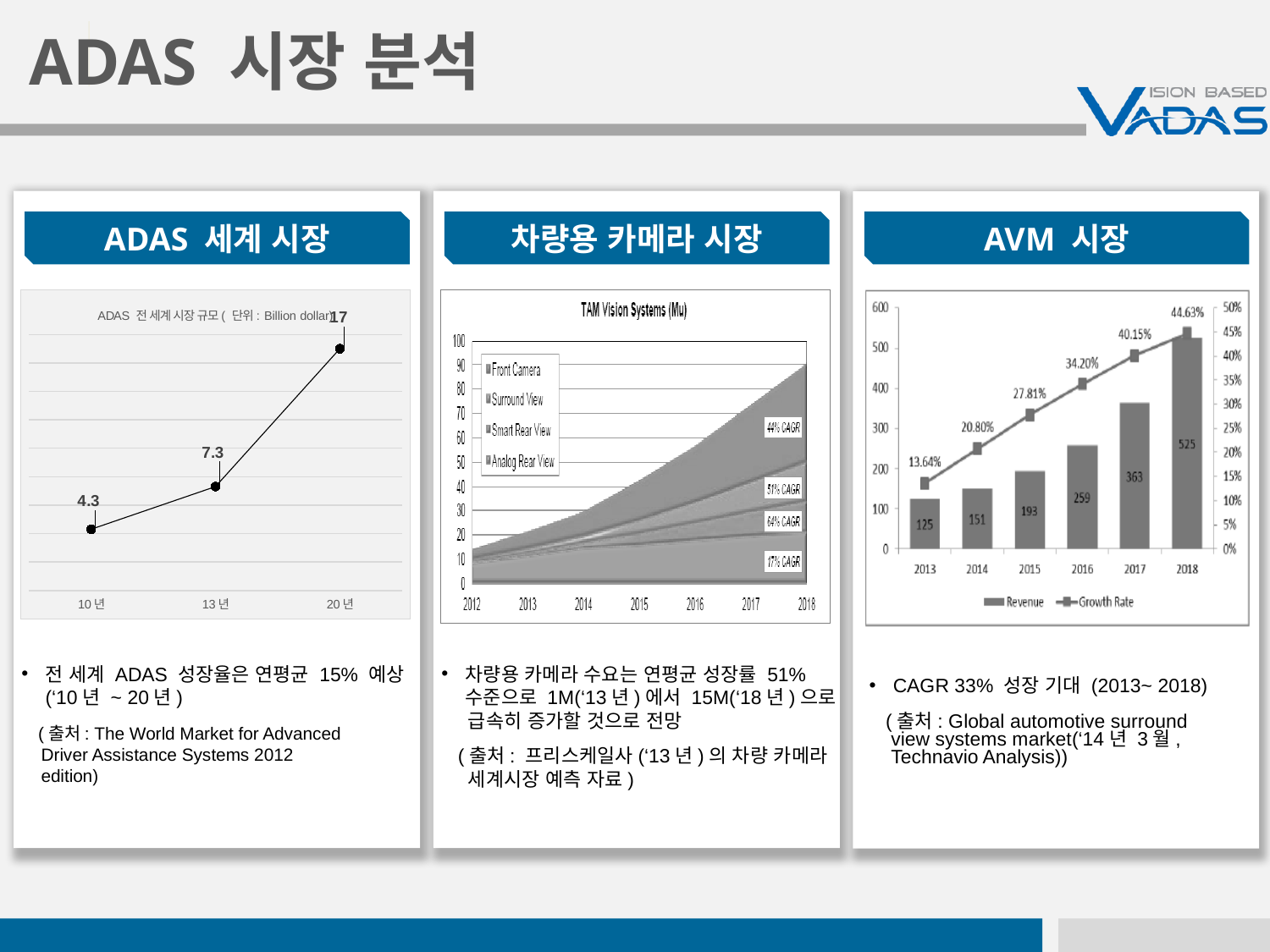
In the ADAS 세계 시장 chart on the left, what is the value for 20년? 17 In the AVM 시장 chart on the right, what is the Revenue value for 2016? 259 In the ADAS 세계 시장 chart on the left, what is the value for 13년? 7.3 In the ADAS 세계 시장 chart on the left, how many data points are plotted? 3 In the ADAS 세계 시장 chart on the left, what is the difference between the values for 20년 and 10년? 12.7 In the ADAS 세계 시장 chart on the left, do the values rise or fall from 10년 to 20년? rise In the AVM 시장 chart on the right, what is the Growth Rate for 2015? 27.81% In the TAM Vision Systems chart in the middle, how many series does the legend list? 4 In the AVM 시장 chart on the right, which is larger, the Revenue for 2014 or for 2015? 2015 In the AVM 시장 chart on the right, which year has the highest Revenue? 2018 In the AVM 시장 chart on the right, what is the difference in Revenue between 2018 and 2017? 162 In the TAM Vision Systems chart in the middle, what is the first entry in the legend? Front Camera